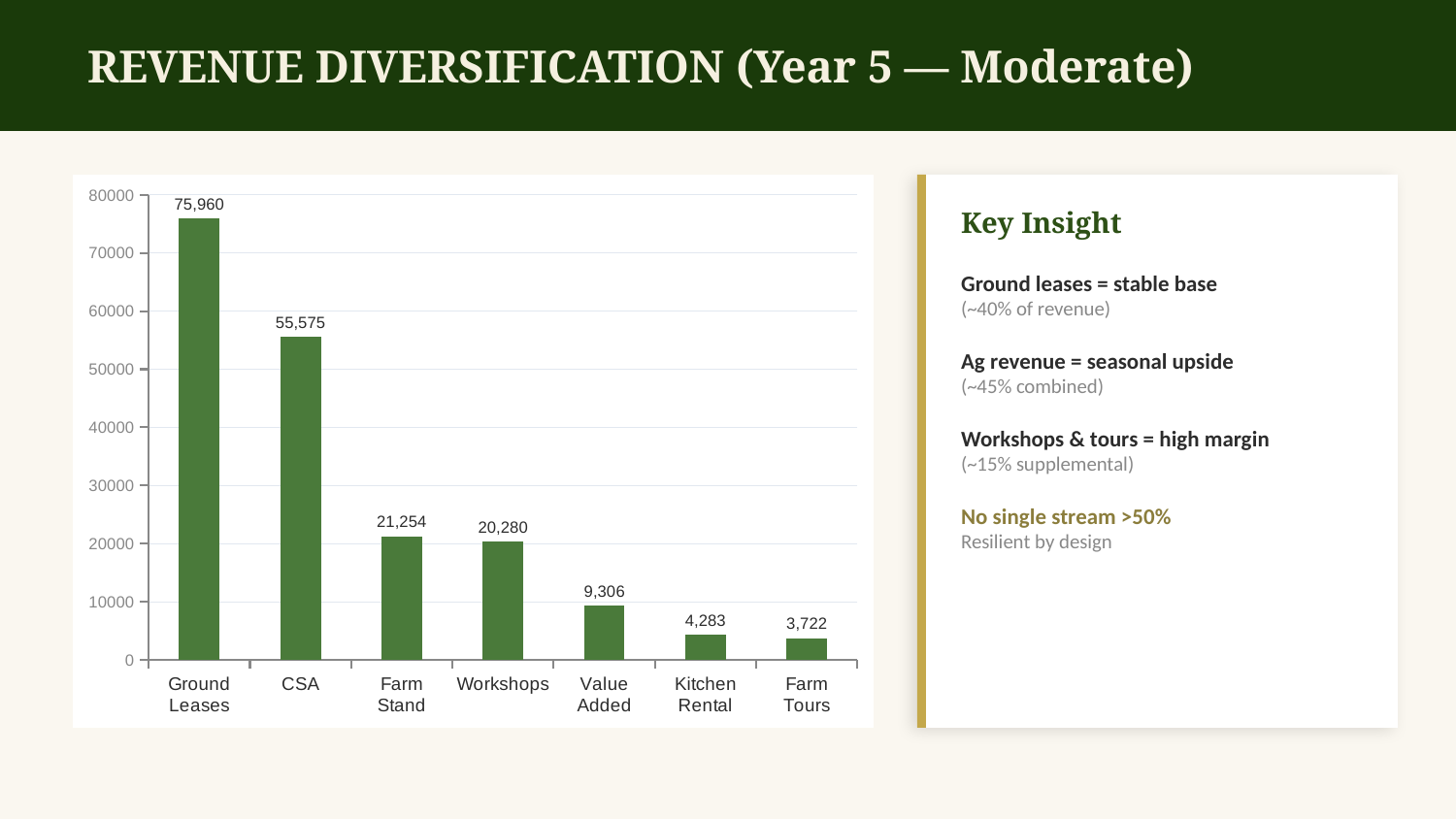
What kind of chart is shown on the slide? Bar chart Which category has the highest value? Ground Leases How many categories are shown on the x axis? 7 What is the value for CSA? 55,575 What is the value for Kitchen Rental? 4,283 What is the value for Farm Stand? 21,254 What is the difference between the values for Farm Stand and Workshops? 974 Which category has the lowest value? Farm Tours Which is larger, the value for Value Added or the value for Kitchen Rental? Value Added What is the value for Ground Leases? 75,960 Is the value for Workshops greater or less than 30000? less What is the difference between the values for Ground Leases and CSA? 20,385